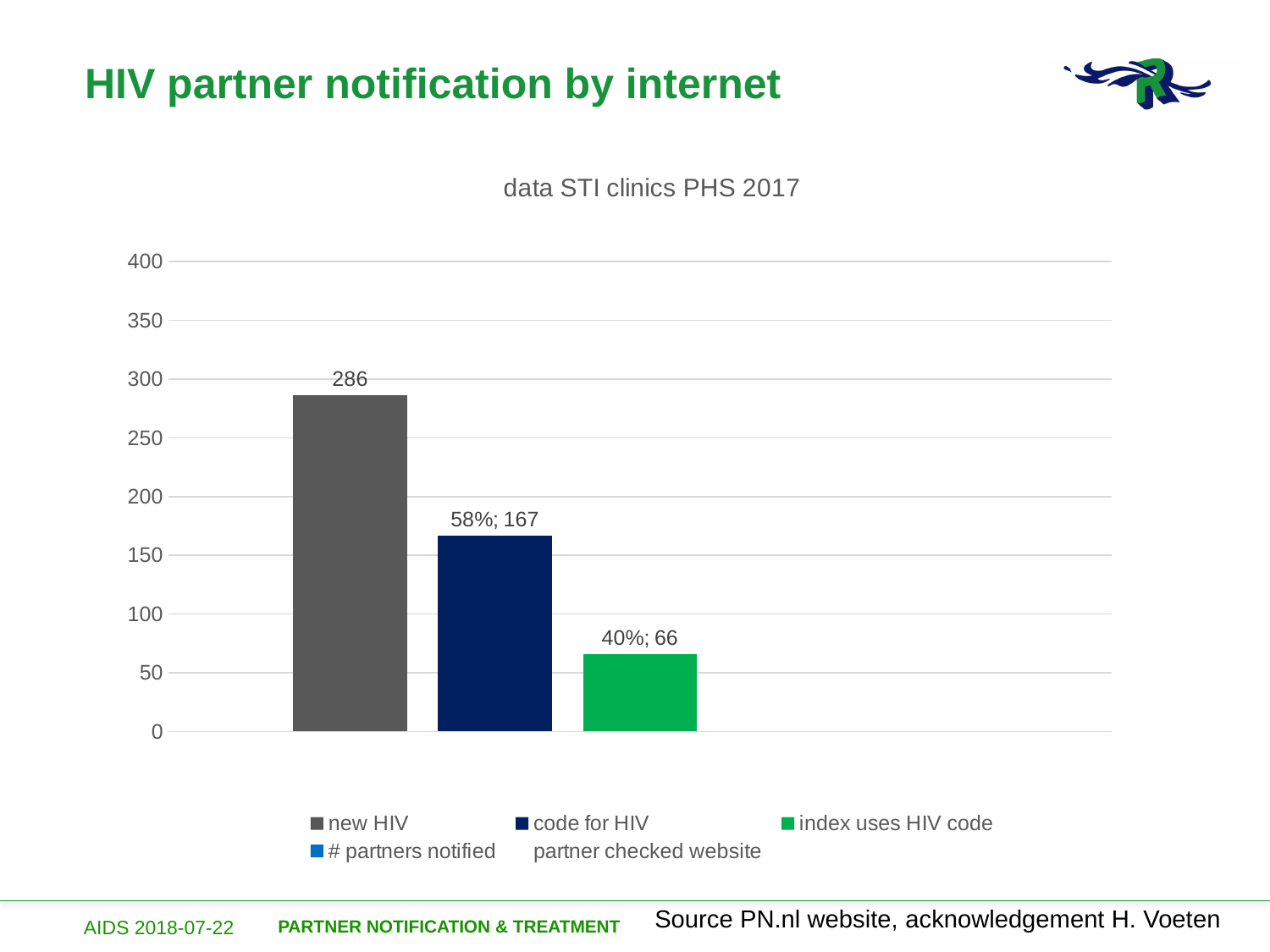
What is the difference between the new HIV value and the code for HIV value? 119 Which is larger, the code for HIV bar or the index uses HIV code bar? code for HIV Which series has the highest bar? new HIV What data label is shown on the code for HIV bar? 58%; 167 What is the difference between the code for HIV value and the index uses HIV code value? 101 How many bars are plotted in the chart? 3 Is the value for new HIV greater or less than 250? greater What is the value of the new HIV bar? 286 Which series has the lowest bar? index uses HIV code What data label is shown on the index uses HIV code bar? 40%; 66 How many entries does the legend list? 5 What type of chart is shown on the slide? bar chart